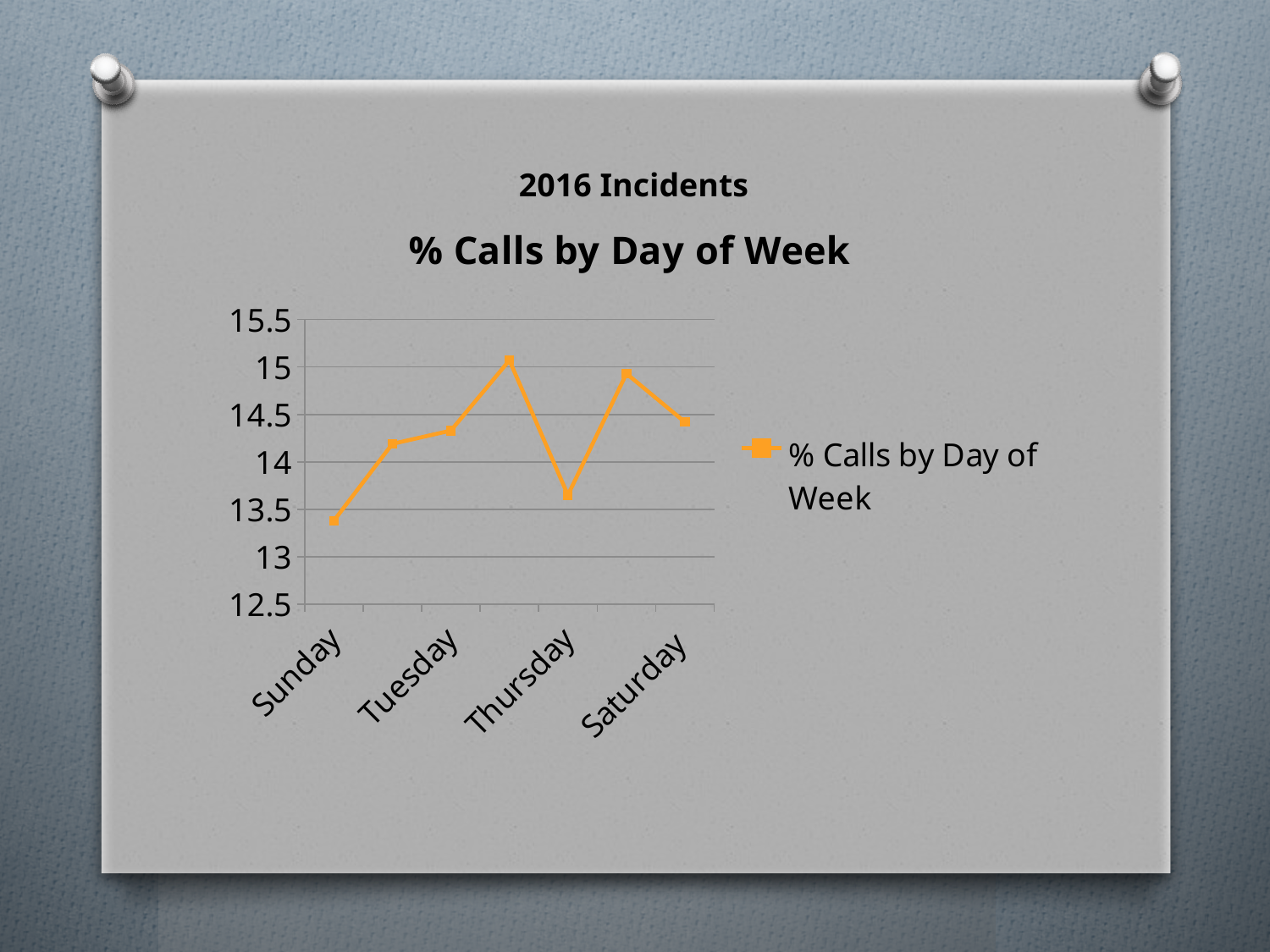
Which has a higher value, Sunday or Saturday? Saturday Which has a higher value, Tuesday or Thursday? Tuesday Is the value for Saturday greater or less than 14? greater What kind of chart is shown on the slide? line chart Is the value for Tuesday greater or less than 14? greater What is the name of the series shown in the legend? % Calls by Day of Week What is the title of the chart? % Calls by Day of Week Does the line rise or fall from Sunday to Tuesday? rise Is the value for Thursday greater or less than 14? less How many series does the legend list? 1 How many data points are plotted on the line? 7